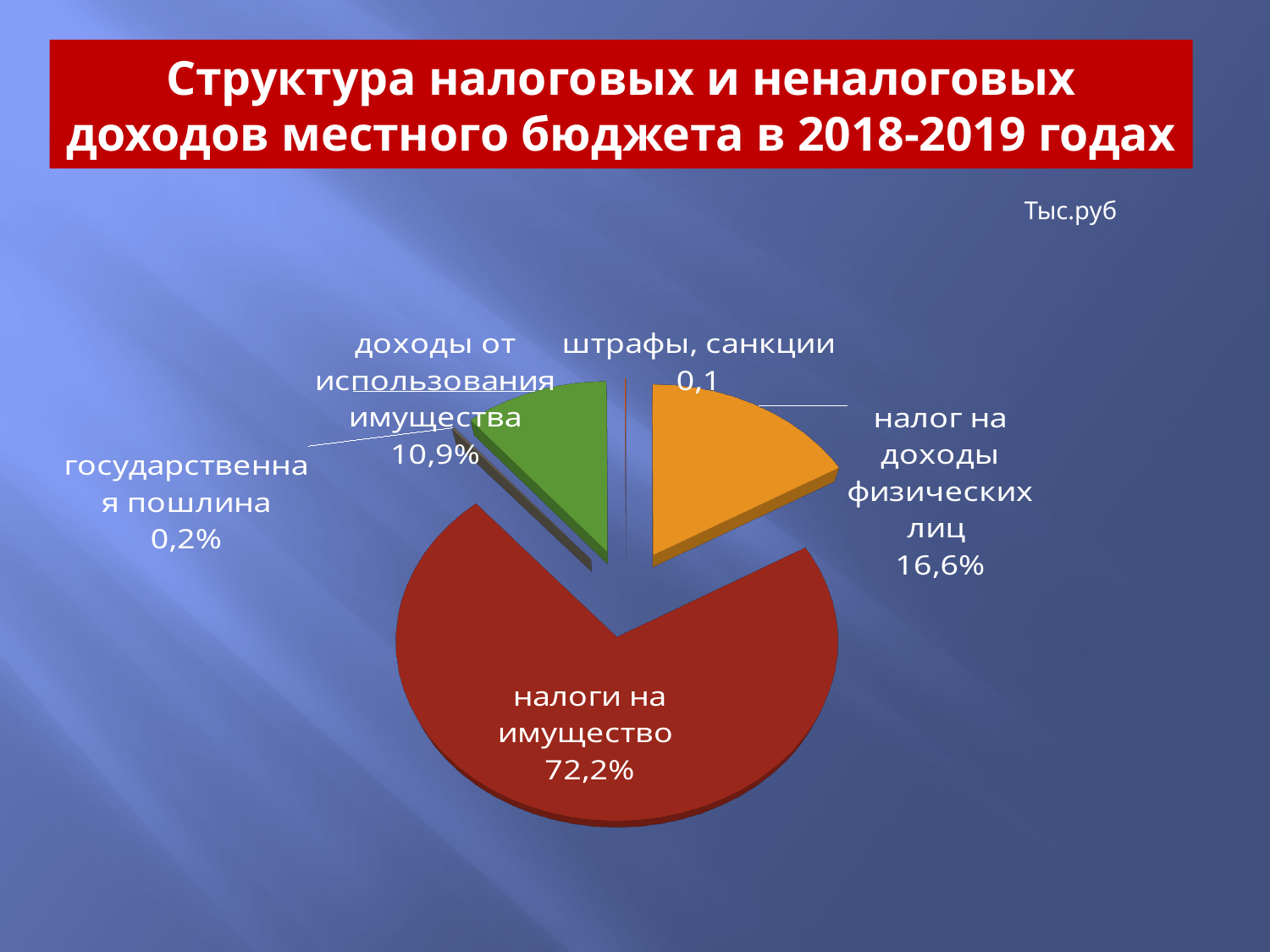
How many slices does the pie chart have? 5 Which category has the smallest slice of the pie? штрафы, санкции What is the title of the slide containing the chart? Структура налоговых и неналоговых доходов местного бюджета в 2018-2019 годах Which category has the largest slice of the pie? налоги на имущество What is the value shown for "государственная пошлина"? 0,2% Which is larger: "налог на доходы физических лиц" or "доходы от использования имущества"? налог на доходы физических лиц What is the difference in percentage points between "налоги на имущество" and "налог на доходы физических лиц"? 55,6 What kind of chart is shown on the slide? pie chart What is the value shown for "налог на доходы физических лиц"? 16,6% What is the value shown for "доходы от использования имущества"? 10,9% What share of the pie does "налоги на имущество" have? 72,2% What value is printed for "штрафы, санкции"? 0,1